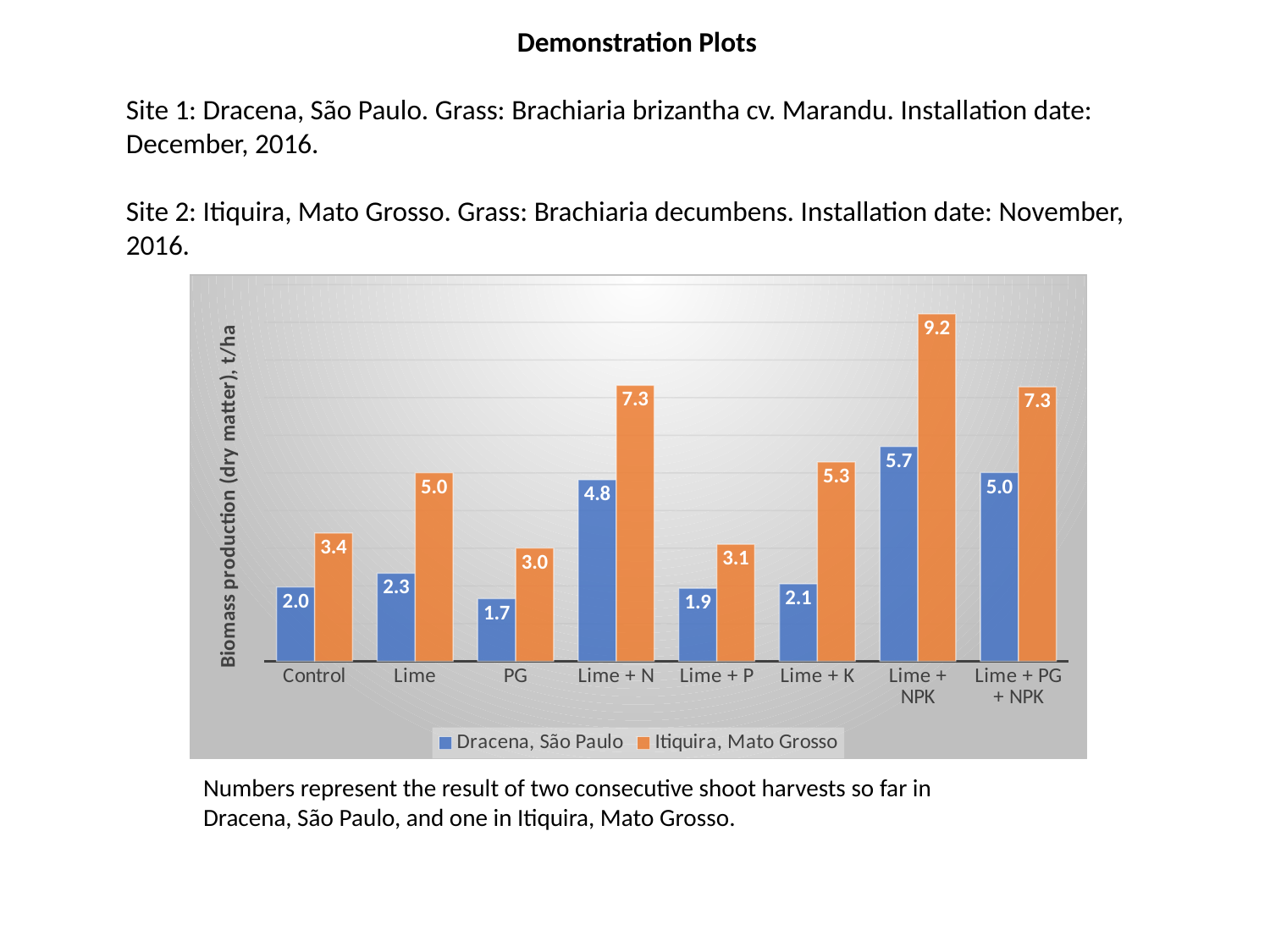
What is the difference between the Itiquira, Mato Grosso and Dracena, São Paulo values for the Lime + NPK treatment? 3.5 How many treatments are shown on the x axis of the chart? 8 Which treatment has the highest biomass production for Itiquira, Mato Grosso? Lime + NPK What is the difference between the Lime + N and Lime + P values for Dracena, São Paulo? 2.9 What is the label of the vertical axis of the chart? Biomass production (dry matter), t/ha How many series does the chart legend list? 2 Which treatment has the lowest biomass production for Dracena, São Paulo? PG What kind of chart is shown on the slide? Bar chart What is the biomass production for Dracena, São Paulo under the Lime + N treatment? 4.8 Which site has the larger biomass production under the Lime + K treatment? Itiquira, Mato Grosso What is the biomass production for Itiquira, Mato Grosso under the Control treatment? 3.4 Which colour represents Itiquira, Mato Grosso in the chart? Orange